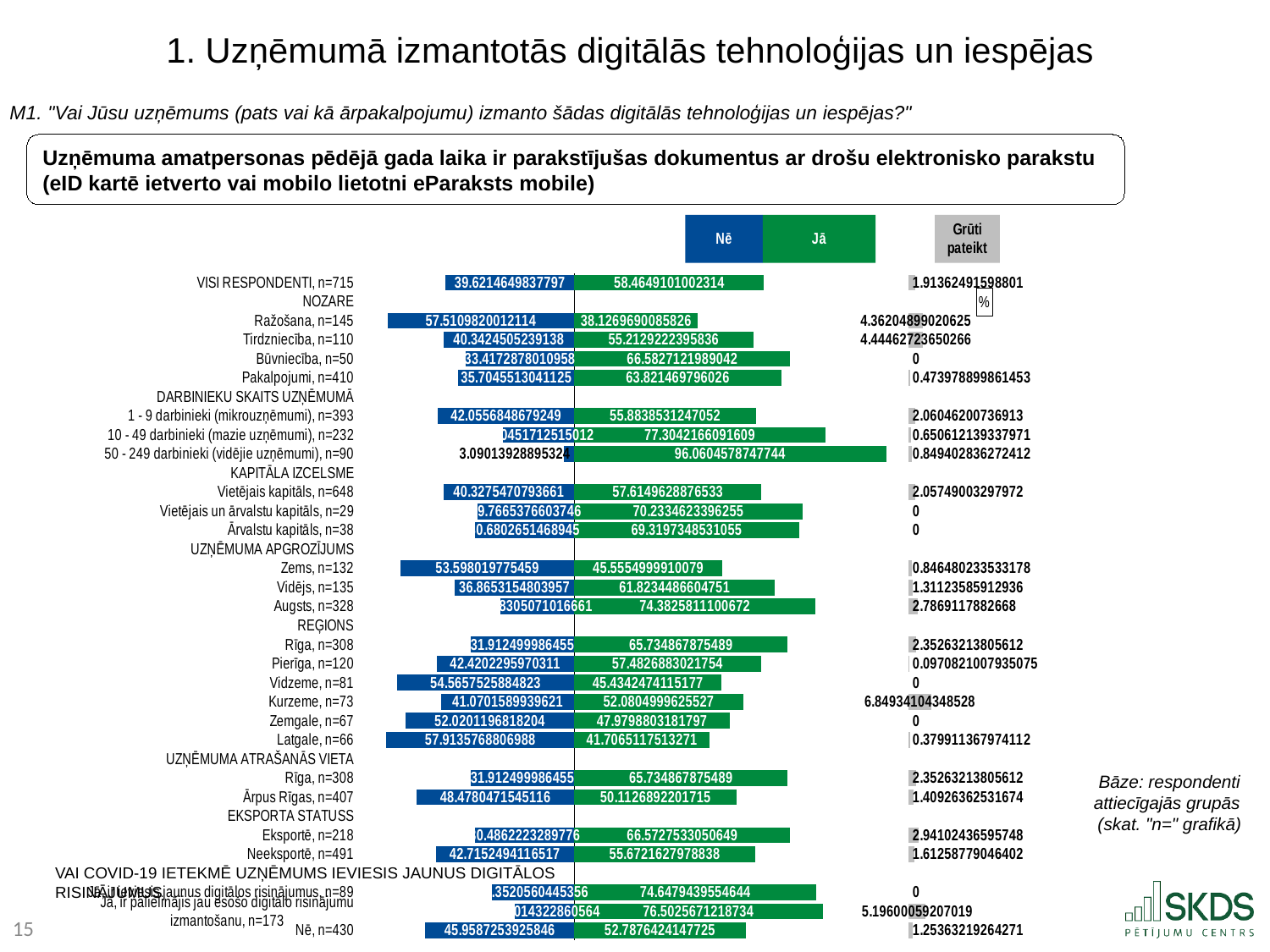
What is the difference between the "Nē" and "Jā" values for Vidzeme, n=81? 9.1315051769646 Which colour represents the "Jā" series in the chart? green Which group has the lowest "Jā" value? Ražošana, n=145 Which is larger for Vidzeme, n=81: the "Nē" value or the "Jā" value? Nē What is the "Jā" value for VISI RESPONDENTI, n=715? 58.4649101002314 What is the "Grūti pateikt" value for Zemgale, n=67? 0 Which group has the highest "Jā" value? 50 - 249 darbinieki (vidējie uzņēmumi), n=90 How many series does the chart's legend list? 3 What is the "Grūti pateikt" value for Kurzeme, n=73? 6.84934104348528 What is the total of the "Nē" and "Jā" values for Būvniecība, n=50? 100 What is the "Nē" value for Ražošana, n=145? 57.5109820012114 What kind of chart is shown on the slide? bar chart